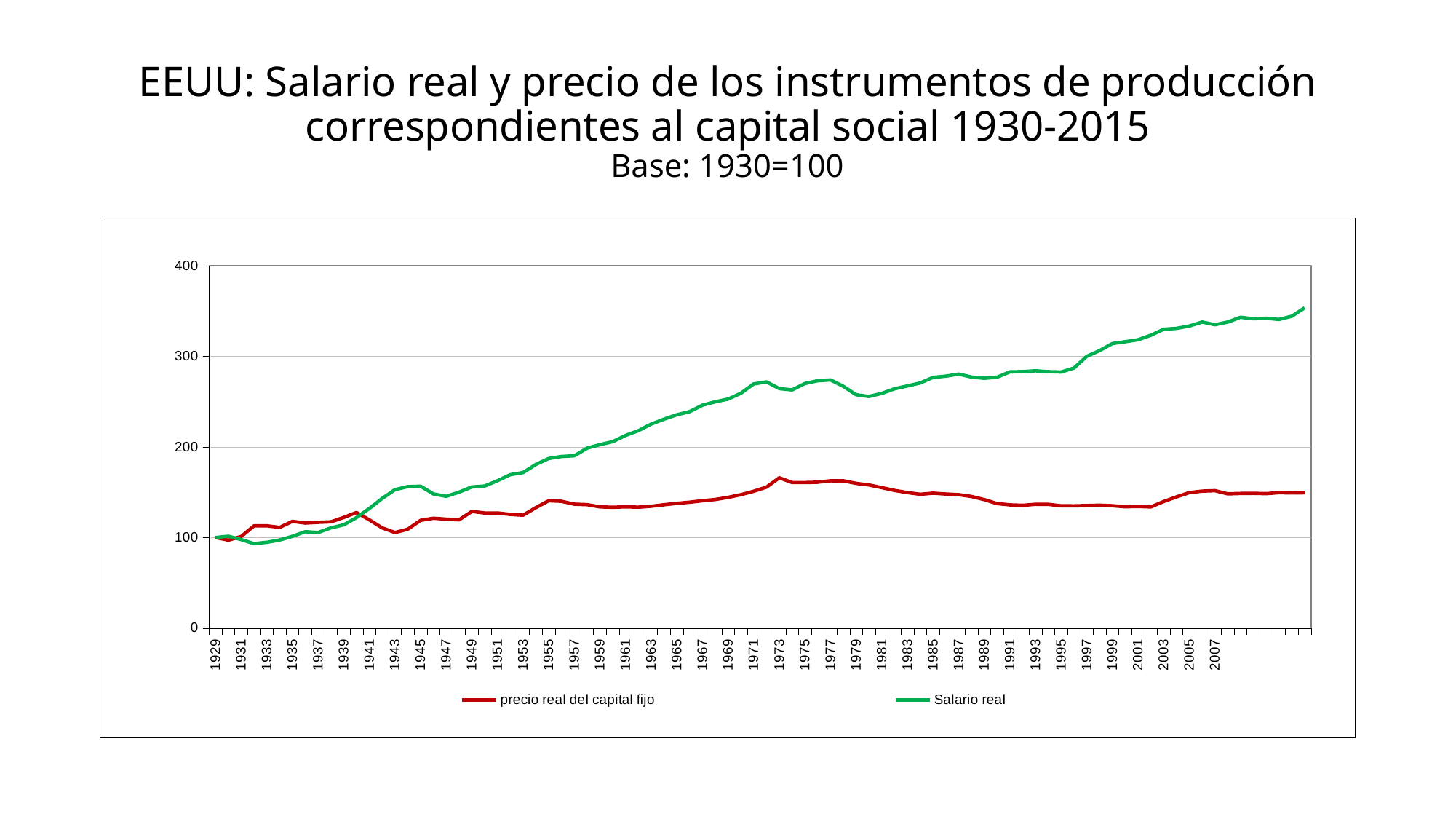
Is the value of Salario real in 1949 greater or less than 200? less Is the value of precio real del capital fijo in 1973 greater or less than 200? less What kind of chart is shown on the slide? line chart Which series is drawn in green? Salario real In 2007, which series has the higher value, Salario real or precio real del capital fijo? Salario real Does the Salario real series generally rise or fall from 1929 to the end of the period? rise How many series does the legend list? 2 Is the value of Salario real in 2007 greater or less than 300? greater What base year and value does the subtitle give for the index? 1930=100